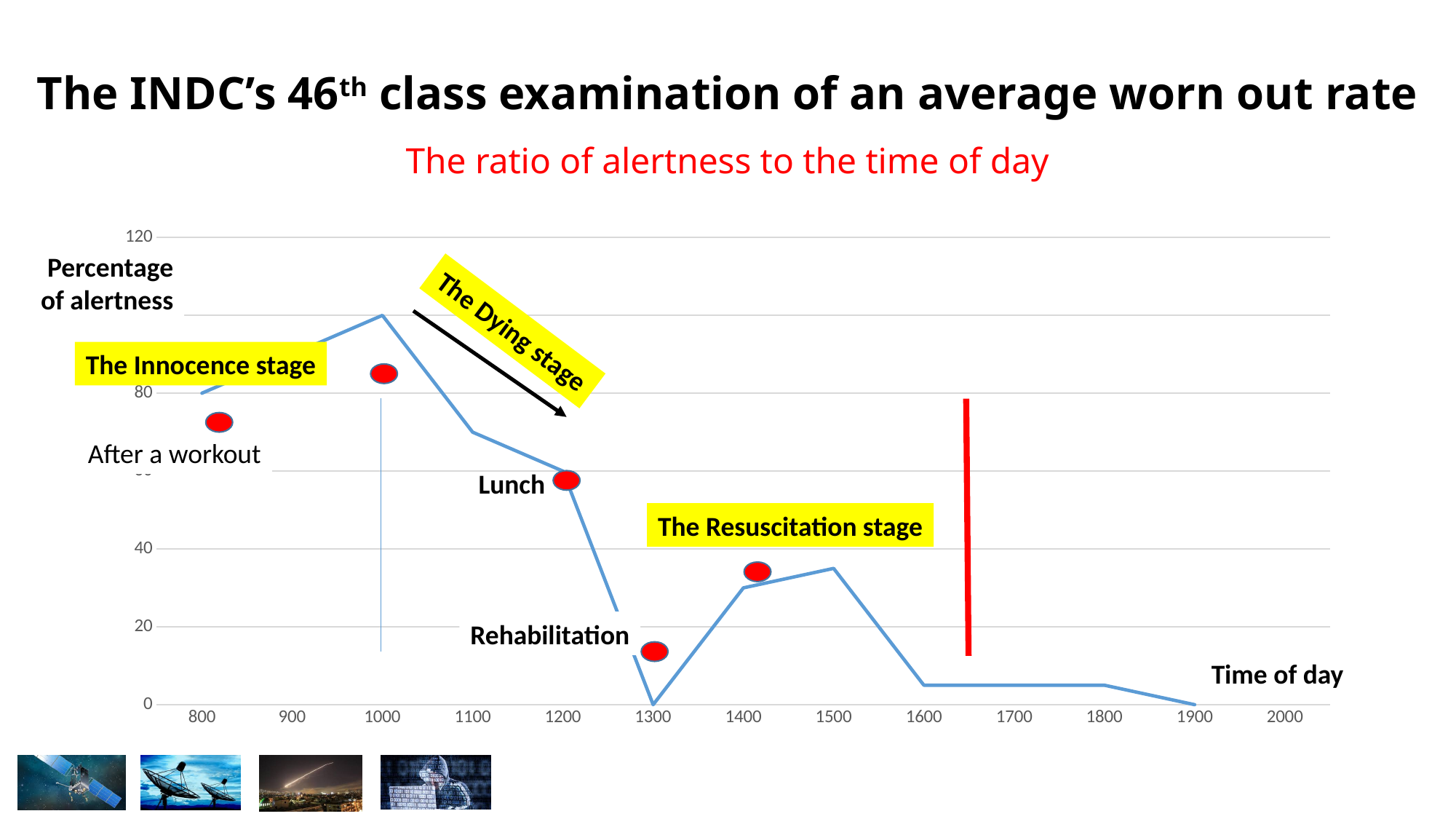
Is the percentage of alertness at 1600 greater or less than 20? less Is the percentage of alertness at 1400 greater or less than 40? less Is the percentage of alertness at 1100 greater or less than 60? greater At which time of day does the percentage of alertness reach its highest value? 1000 Which has a higher percentage of alertness, 1100 or 1200? 1100 What kind of chart is shown on the slide? line chart What is the label on the vertical axis of the chart? Percentage of alertness What is the difference between the percentage of alertness at 1000 and at 800? 20 What is the percentage of alertness at 1000? 100 Does the percentage of alertness rise or fall between 1000 and 1300? fall What is the percentage of alertness at 1300? 0 What is the percentage of alertness at 800? 80